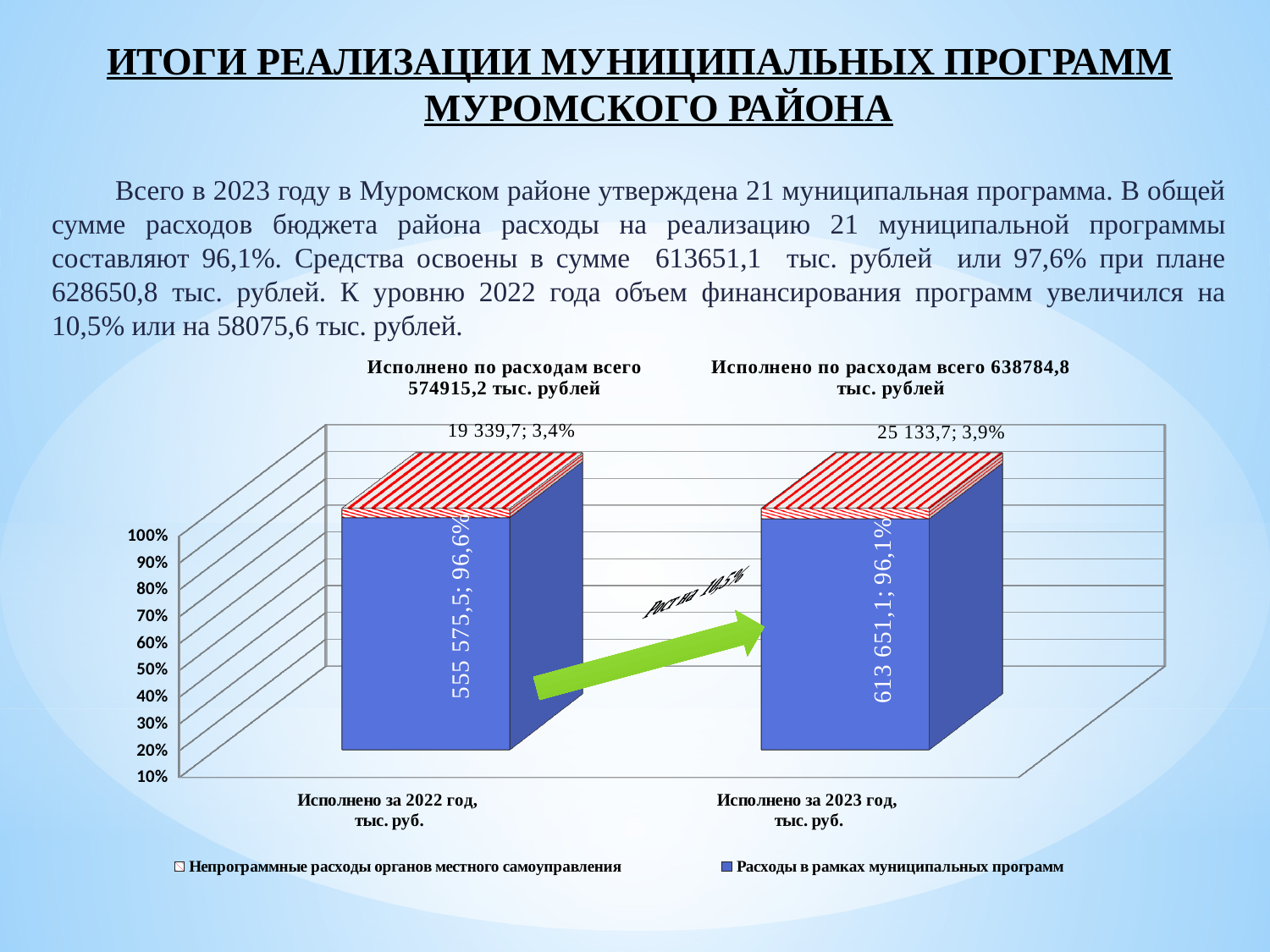
What is the value of 'Расходы в рамках муниципальных программ' for 'Исполнено за 2022 год, тыс. руб.'? 555 575,5 What is the value of 'Расходы в рамках муниципальных программ' for 'Исполнено за 2023 год, тыс. руб.'? 613 651,1 What is the total of the bar for 'Исполнено за 2023 год, тыс. руб.' as printed above the chart? 638784,8 тыс. рублей What is the value of 'Непрограммные расходы органов местного самоуправления' for 'Исполнено за 2022 год, тыс. руб.'? 19 339,7 Which series is shown in blue in the chart legend? Расходы в рамках муниципальных программ How many series does the chart legend list? 2 What percentage share do 'Расходы в рамках муниципальных программ' make up in the 2023 bar? 96,1% Which category has the larger value for 'Расходы в рамках муниципальных программ', 2022 or 2023? Исполнено за 2023 год, тыс. руб. What percentage share do 'Непрограммные расходы органов местного самоуправления' make up in the 2022 bar? 3,4% How many categories are shown on the x axis of the chart? 2 What is the value of 'Непрограммные расходы органов местного самоуправления' for 'Исполнено за 2023 год, тыс. руб.'? 25 133,7 What kind of chart is shown on the slide? stacked bar chart